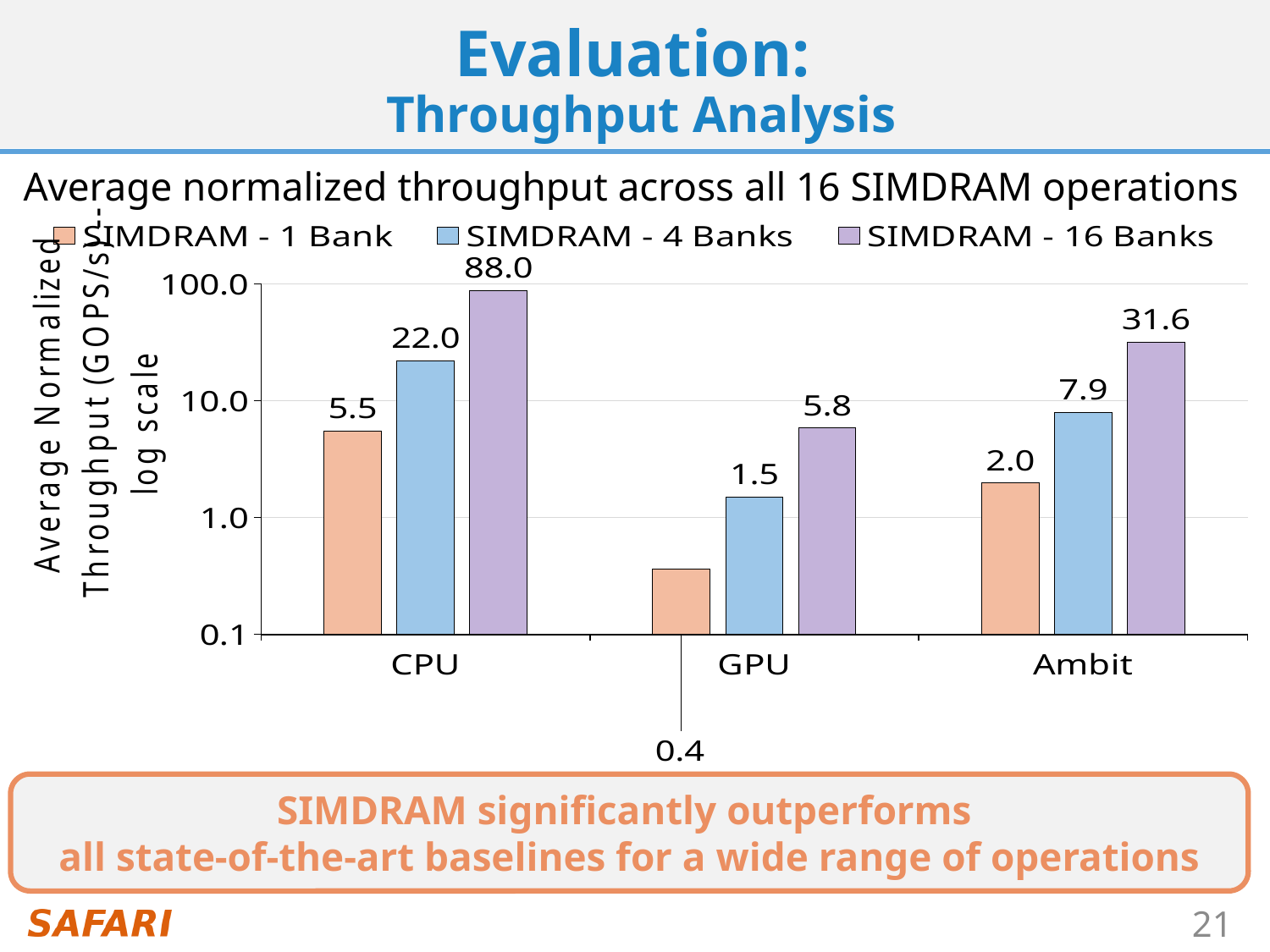
What is the y-axis label of the chart? Average Normalized Throughput (GOPS/s) - log scale What is the value for SIMDRAM - 1 Bank for GPU? 0.4 Which is larger: the SIMDRAM - 4 Banks value for CPU or the SIMDRAM - 16 Banks value for Ambit? SIMDRAM - 16 Banks value for Ambit Which category has the lowest value for SIMDRAM - 1 Bank? GPU What is the value for SIMDRAM - 4 Banks for Ambit? 7.9 What is the value for SIMDRAM - 16 Banks for CPU? 88.0 How many categories are shown on the x axis? 3 How many series does the legend list? 3 What kind of chart is shown on the slide? bar chart Which category has the highest value for SIMDRAM - 16 Banks? CPU Is the value for SIMDRAM - 16 Banks for GPU greater or less than 10.0? less What is the difference between the SIMDRAM - 16 Banks value and the SIMDRAM - 1 Bank value for Ambit? 29.6